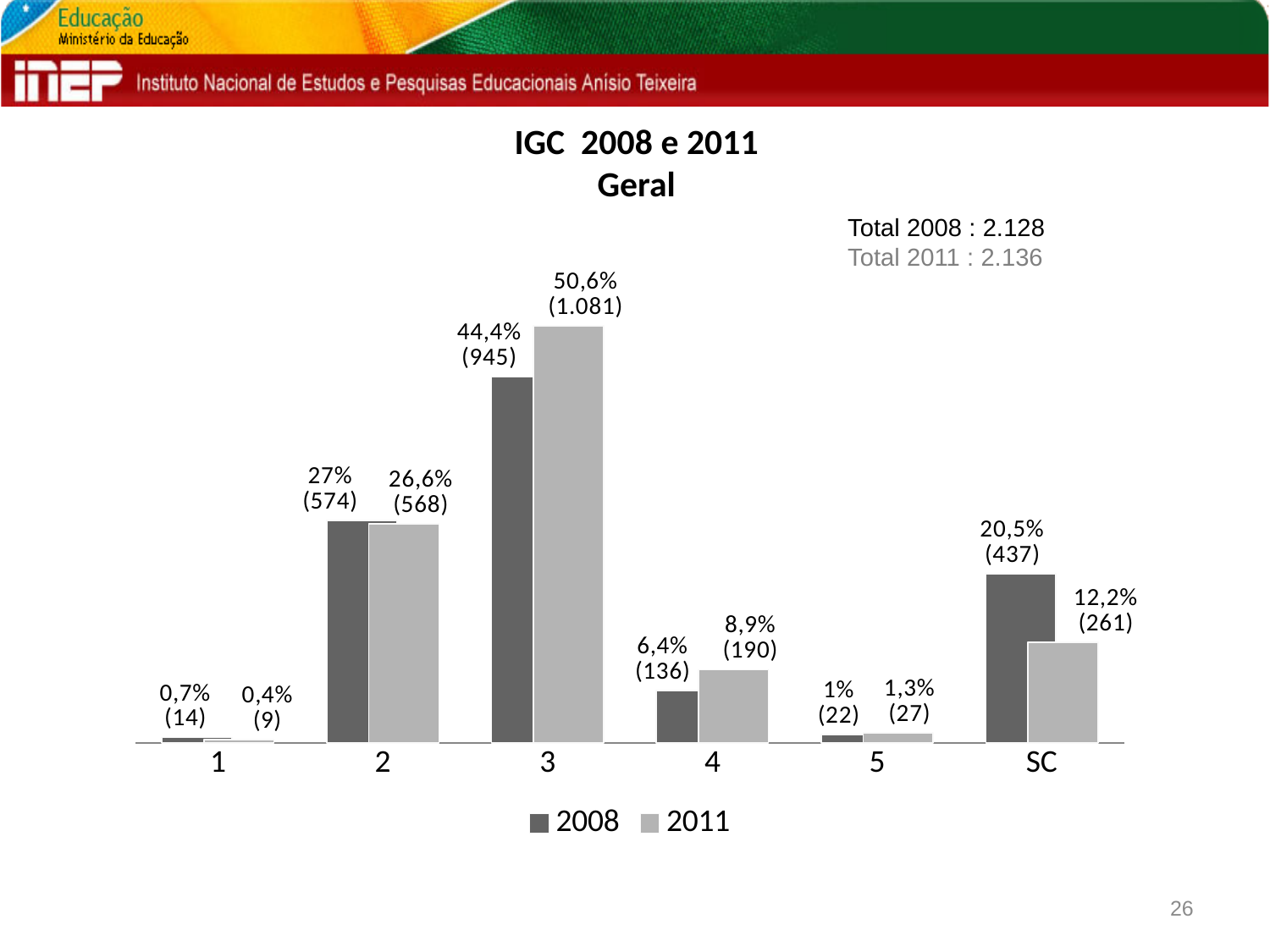
Which is larger for category 4, the 2008 value or the 2011 value? 2011 Which category has the highest value in the 2008 series? 3 What is the value for category 3 in the 2011 series? 50,6% (1.081) Which is larger for category SC, the 2008 value or the 2011 value? 2008 Which category has the lowest value in the 2011 series? 1 How many series does the legend list? 2 What is the total for 2011 shown on the slide? 2.136 How many categories are shown on the x axis? 6 What kind of chart is shown on the slide? Bar chart What is the value for category 4 in the 2011 series? 8,9% (190) What is the value for category SC in the 2008 series? 20,5% (437) What is the difference in count between 2011 and 2008 for category 3? 136